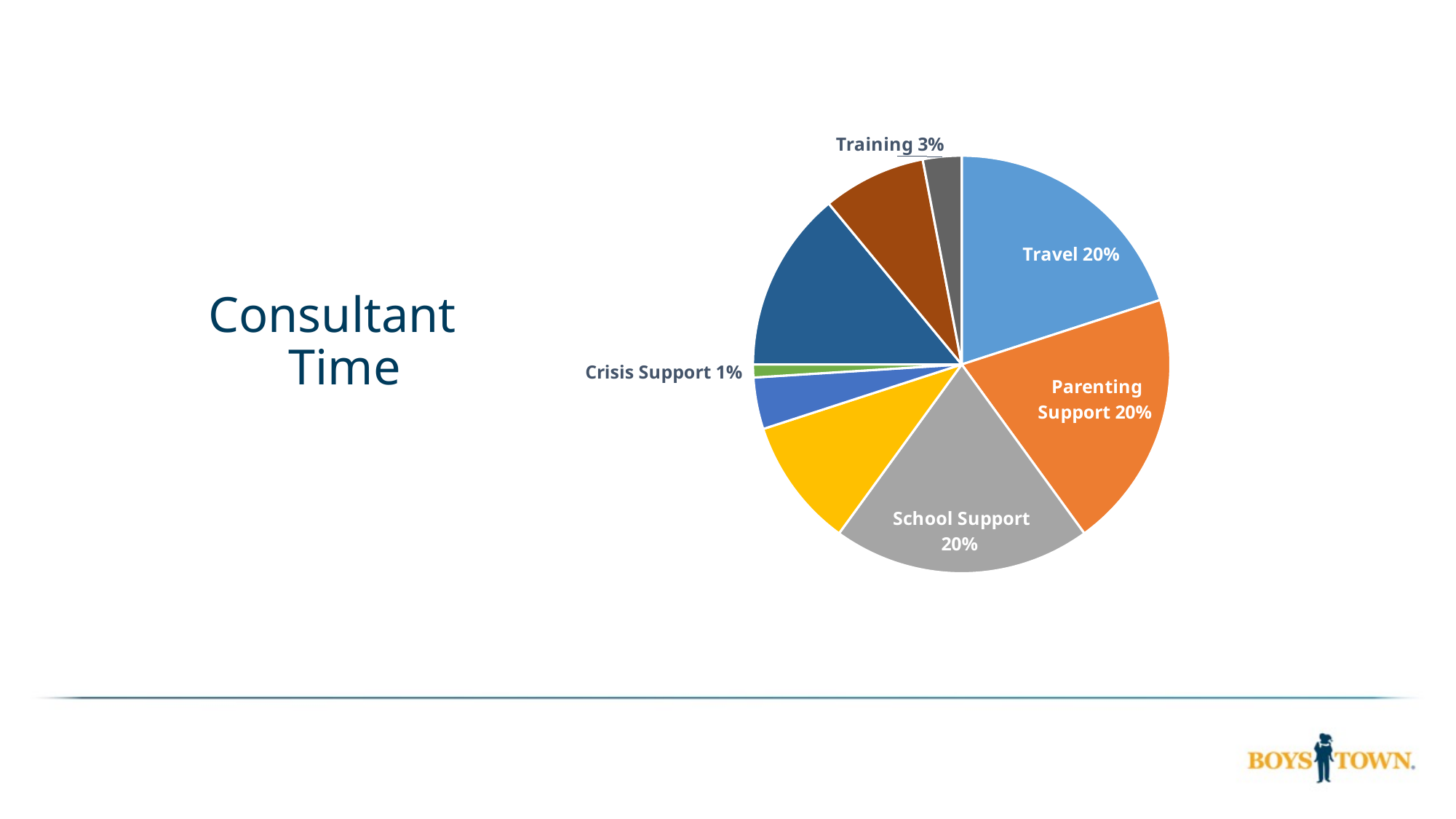
What is the difference in percentage points between Travel and Training? 17% What percentage is shown for School Support? 20% How many slices does the pie chart have? 9 What share of consultant time is spent on Travel? 20% Which labeled category has the smallest share of consultant time? Crisis Support Which is larger, the share for Travel or the share for Training? Travel What is the difference in percentage points between Training and Crisis Support? 2% What percentage is shown for Crisis Support? 1% What percentage is shown for Training? 3% What percentage is shown for Parenting Support? 20% What is the title of the chart on the slide? Consultant Time What type of chart is shown on the slide? pie chart